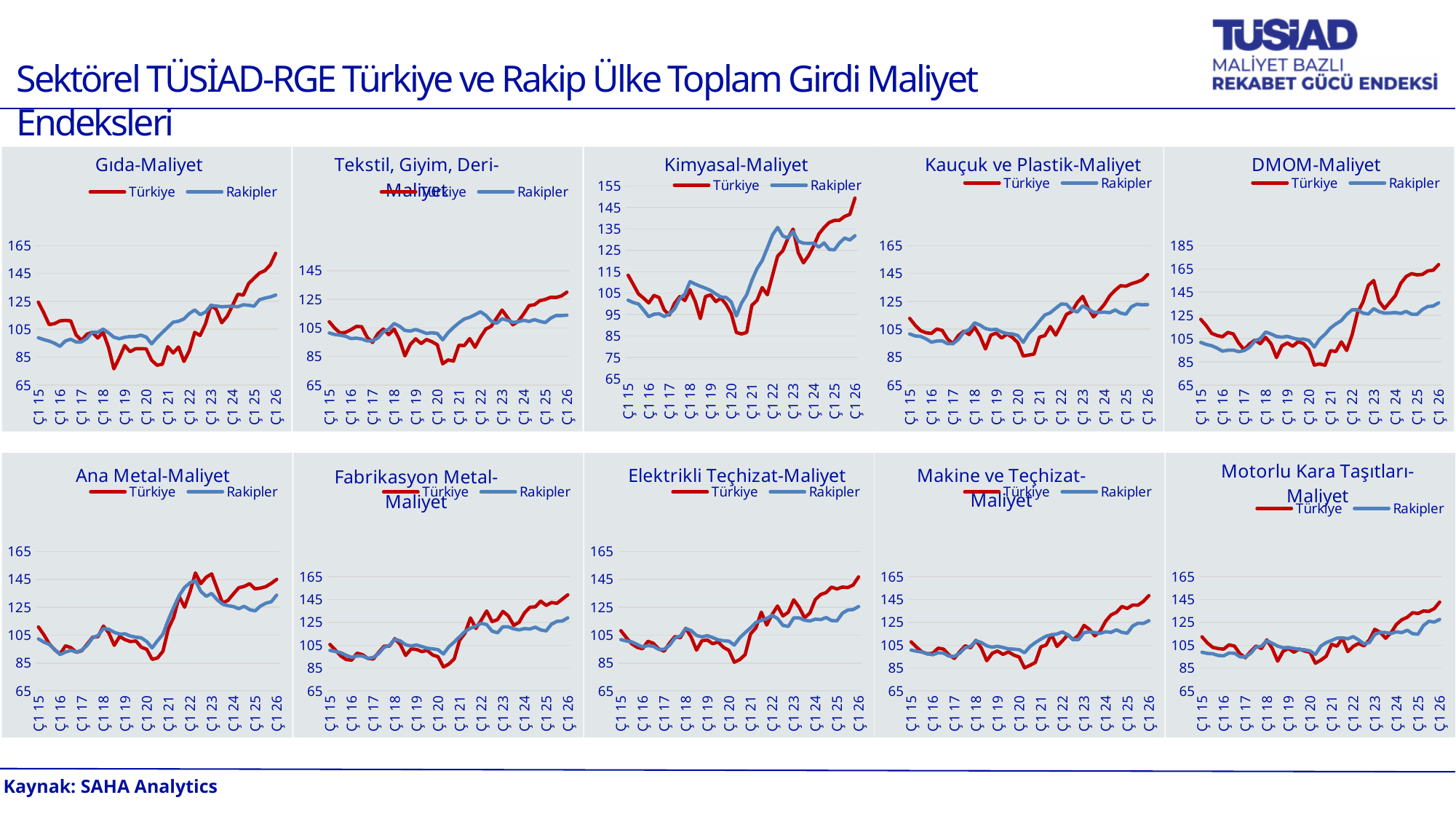
In the Makine ve Teçhizat-Maliyet chart, is the Türkiye value at Ç1 26 greater or less than 125? greater In the Kauçuk ve Plastik-Maliyet chart, is the Türkiye value at Ç1 20 greater or less than 105? less In the Kimyasal-Maliyet chart, is the Türkiye value at Ç1 26 greater or less than 145? greater In the Ana Metal-Maliyet chart, which series has the higher value at Ç1 26, Türkiye or Rakipler? Türkiye How many series does the legend of the Kimyasal-Maliyet chart list? 2 In the DMOM-Maliyet chart, which series has the higher value at Ç1 26, Türkiye or Rakipler? Türkiye What are the two series named in the legend of the DMOM-Maliyet chart? Türkiye and Rakipler In the Kimyasal-Maliyet chart, does the Rakipler series rise or fall between Ç1 20 and Ç1 22? rise What kind of chart is the Gıda-Maliyet chart? Line chart How many charts are shown on the slide? 10